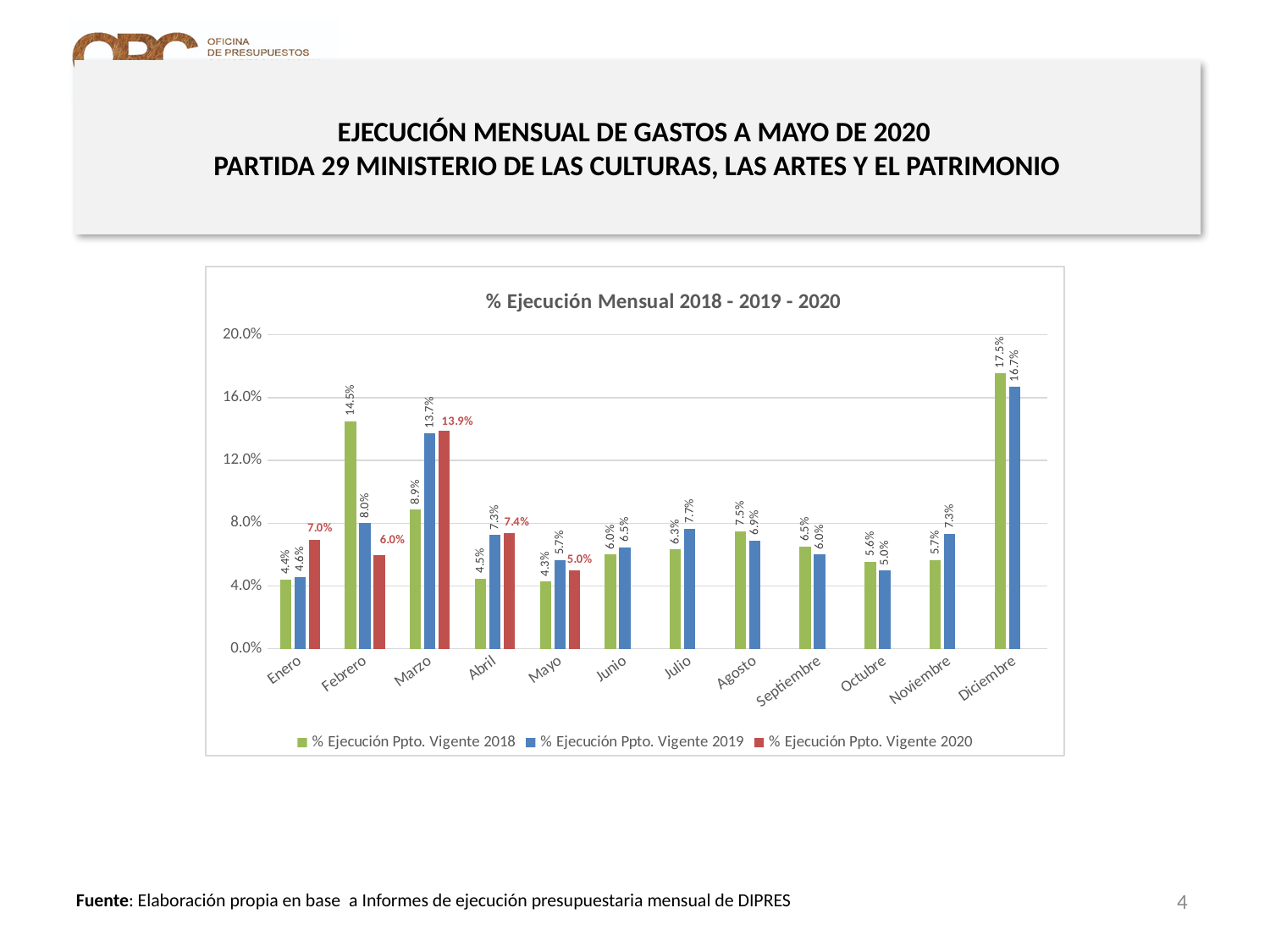
What type of chart is shown on the slide? bar chart How many months are shown on the x axis? 12 Is the value for % Ejecución Ppto. Vigente 2019 in Marzo greater or less than 12.0%? greater How many series does the legend list? 3 What is the value for % Ejecución Ppto. Vigente 2020 in Marzo? 13.9% In which month is the % Ejecución Ppto. Vigente 2018 value lowest? Mayo What is the difference between the 2018 and 2019 values in Diciembre? 0.8% What is the title of the chart? % Ejecución Mensual 2018 - 2019 - 2020 In which month is the % Ejecución Ppto. Vigente 2019 value highest? Diciembre What is the value for % Ejecución Ppto. Vigente 2018 in Febrero? 14.5% What is the value for % Ejecución Ppto. Vigente 2019 in Noviembre? 7.3% Which is larger in Febrero: the 2018 value or the 2019 value? 2018 value (14.5%)